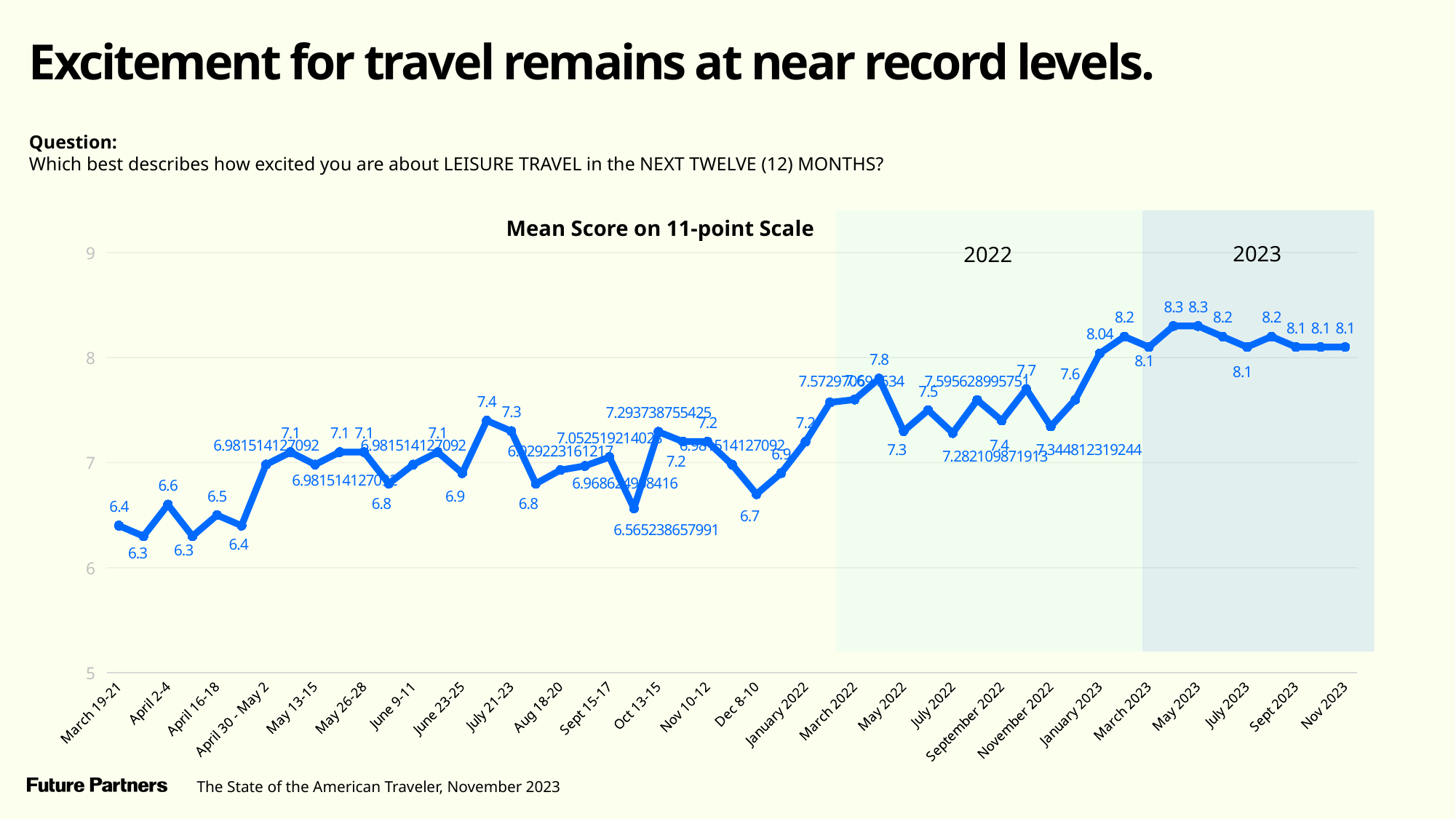
What is the highest mean score shown on the chart? 8.3 What is the mean score for March 19-21, the first point on the chart? 6.4 What type of chart is shown on the slide? line chart What is the difference between the highest mean score (8.3) and the lowest mean score (6.3) on the chart? 2.0 What is the mean score for Nov 2023, the last point on the chart? 8.1 What is the mean score for May 2023? 8.3 What is the title of the chart? Mean Score on 11-point Scale Overall, do the mean scores rise or fall from left to right along the x axis? rise Which is larger, the mean score for March 19-21 or the mean score for Nov 2023? Nov 2023 How many date labels are shown on the x axis? 26 What is the lowest mean score shown on the chart? 6.3 Is the mean score for Dec 8-10 greater or less than 7? less